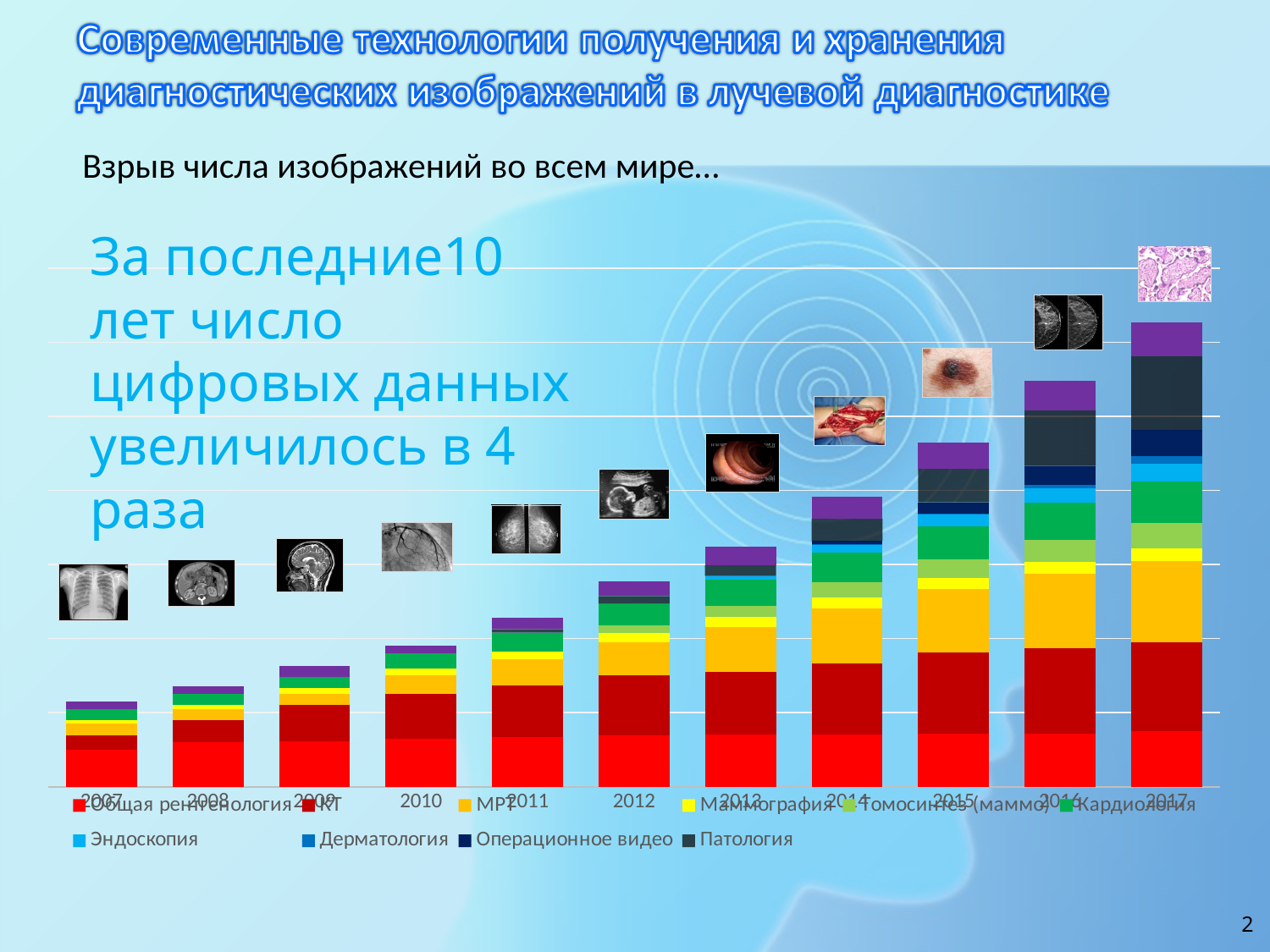
Do the stacked bar totals rise or fall from 2007 to 2017? Rise What is the last year shown on the x axis? 2017 How many years are shown along the x axis of the chart? 11 Which stacked bar is taller, 2012 or 2010? 2012 Which year has the tallest stacked bar? 2017 Which year has the shortest stacked bar? 2007 What is the first entry listed in the chart legend? Общая рентгенология Which stacked bar is taller, 2007 or 2017? 2017 What is the first year shown on the x axis? 2007 What kind of chart is shown on the slide? Stacked bar chart Which series is shown in red at the bottom of each stacked bar? Общая рентгенология